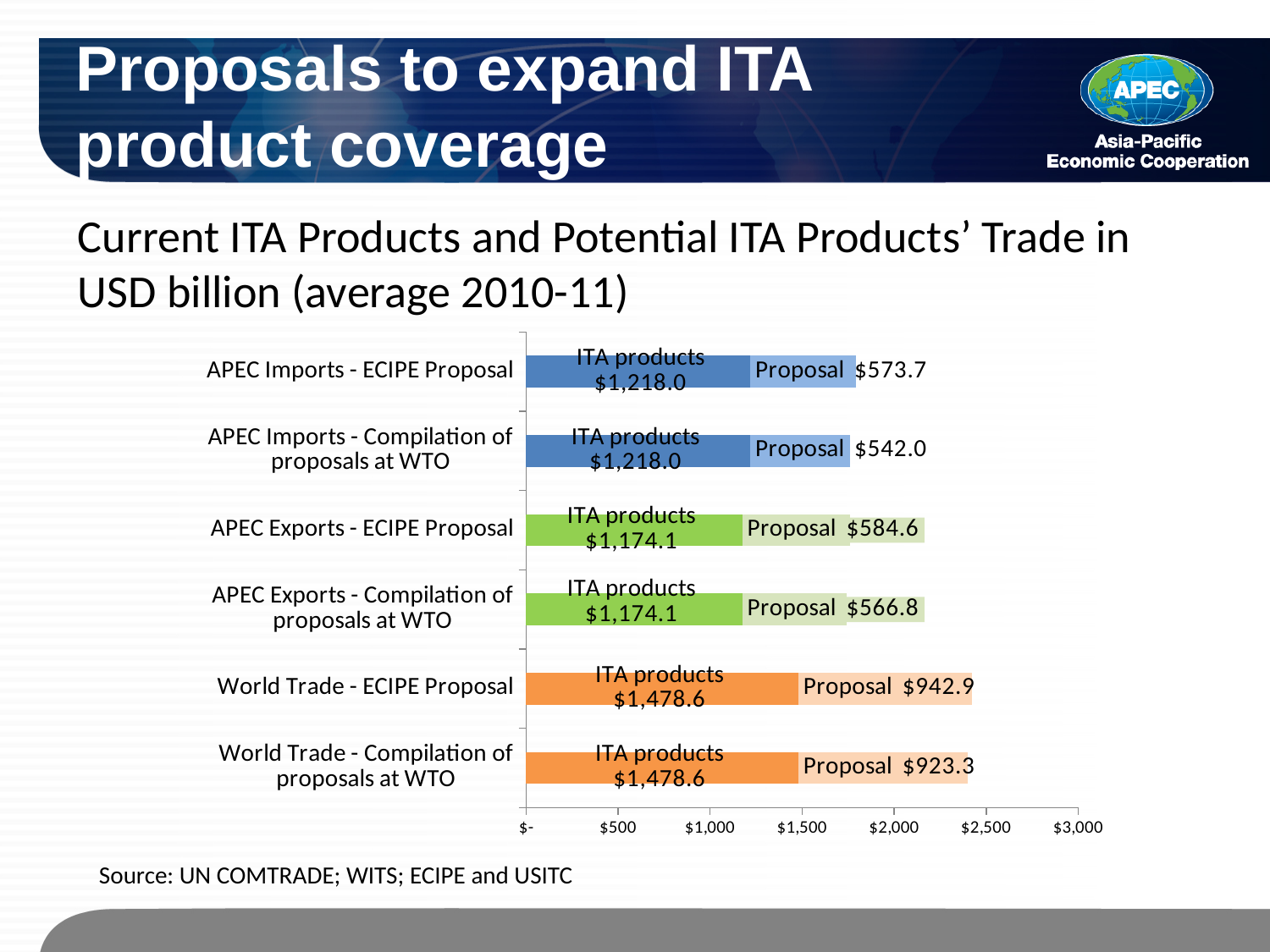
What is the difference between the Proposal values for World Trade - ECIPE Proposal and World Trade - Compilation of proposals at WTO? $19.6 What kind of chart is shown on the slide? Stacked bar chart What is the ITA products value for World Trade - ECIPE Proposal? $1,478.6 What is the Proposal value for APEC Imports - Compilation of proposals at WTO? $542.0 What is the total of the stacked bar for World Trade - ECIPE Proposal? $2,421.5 How many categories are shown on the chart? 6 Which is larger, the ITA products value for APEC Imports - ECIPE Proposal or for APEC Exports - ECIPE Proposal? APEC Imports - ECIPE Proposal Which category has the highest Proposal value? World Trade - ECIPE Proposal Which category has the lowest Proposal value? APEC Imports - Compilation of proposals at WTO What is the total of the stacked bar for APEC Exports - Compilation of proposals at WTO? $1,740.9 What is the difference between the Proposal values for APEC Imports - ECIPE Proposal and APEC Imports - Compilation of proposals at WTO? $31.7 What is the Proposal value for APEC Exports - ECIPE Proposal? $584.6